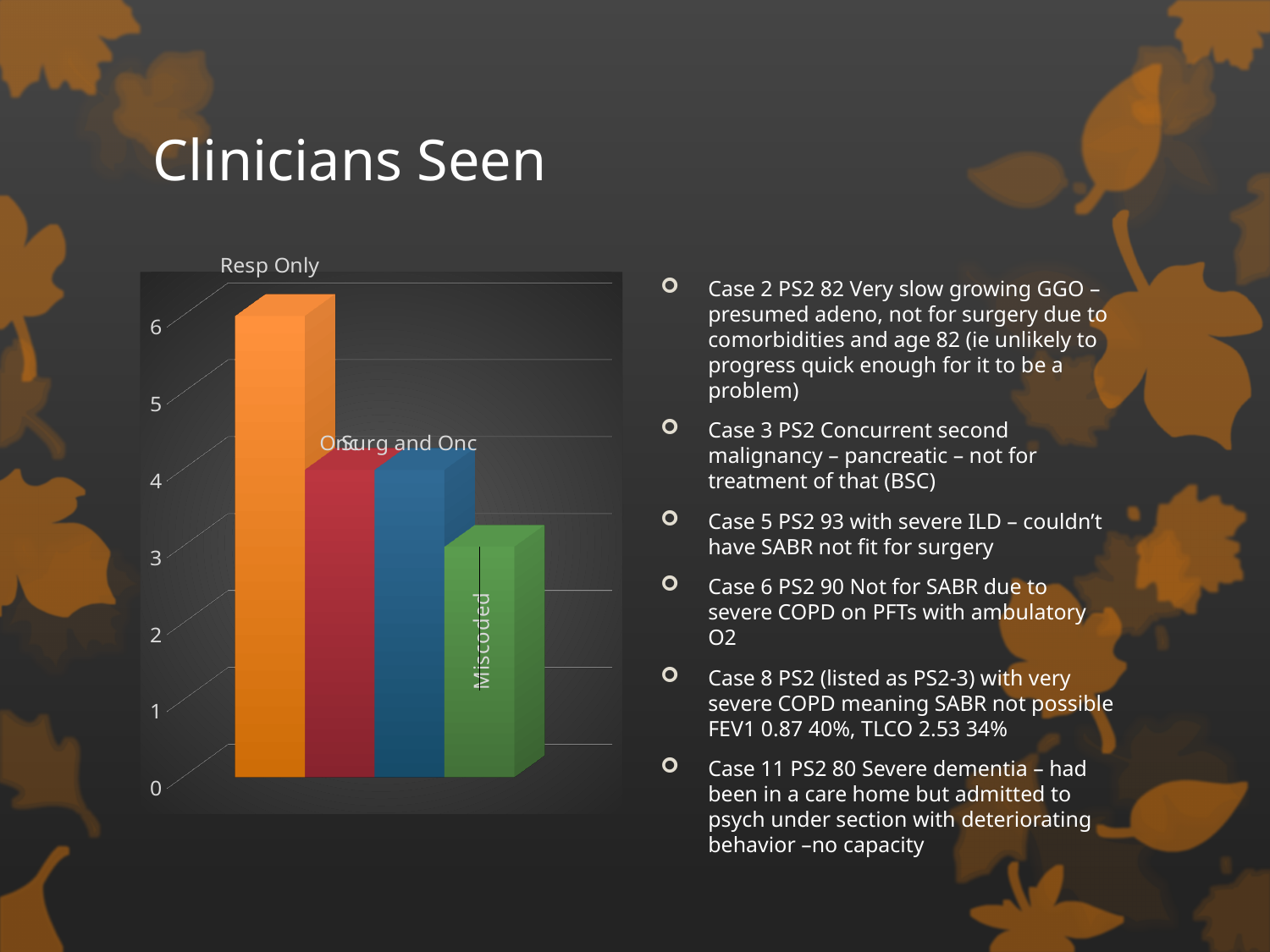
Which is larger, the value for Resp Only or the value for Miscoded? Resp Only Which category has the highest bar in the chart? Resp Only Is the value for Miscoded greater or less than 4? less Which category has the lowest bar in the chart? Miscoded How many bars (categories) does the chart show? 4 Is the value for Surg and Onc greater or less than 5? less Is the value for Miscoded greater or less than 2? greater Which is larger, the value for Onc or the value for Miscoded? Onc What colour is the bar for Resp Only? orange What kind of chart is shown on the slide? bar chart